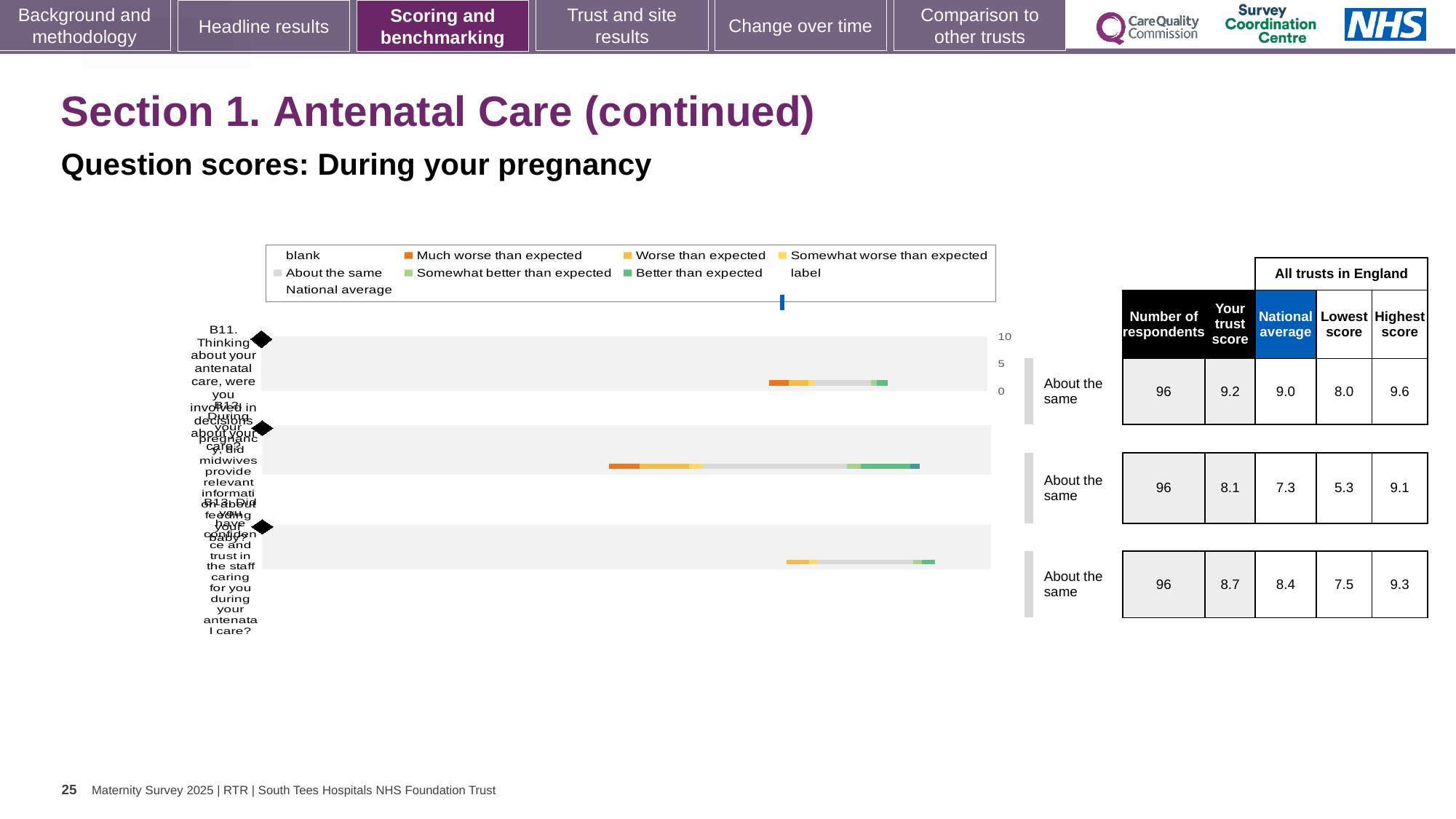
How many questions (bars) are plotted in the chart? 3 According to the table beside the chart, how many respondents answered B13 (confidence and trust in the staff)? 96 For B13, which is larger: the trust score or the national average? the trust score According to the table beside the chart, what is the national average for B12 (midwives provide relevant information about feeding your baby)? 7.3 According to the table beside the chart, what is the 'Your trust score' for B11 (involved in decisions about your care)? 9.2 In the chart legend, what colour represents 'Much worse than expected'? orange Which question has the lowest 'Lowest score' across all trusts in England? B12 What is the difference between the trust score and the national average for B12? 0.8 According to the table beside the chart, what is the highest score across all trusts in England for B11? 9.6 Which question has the highest 'Your trust score' in the table beside the chart? B11 What benchmark category is shown for all three questions on the slide? About the same What kind of chart is shown on the slide? bar chart